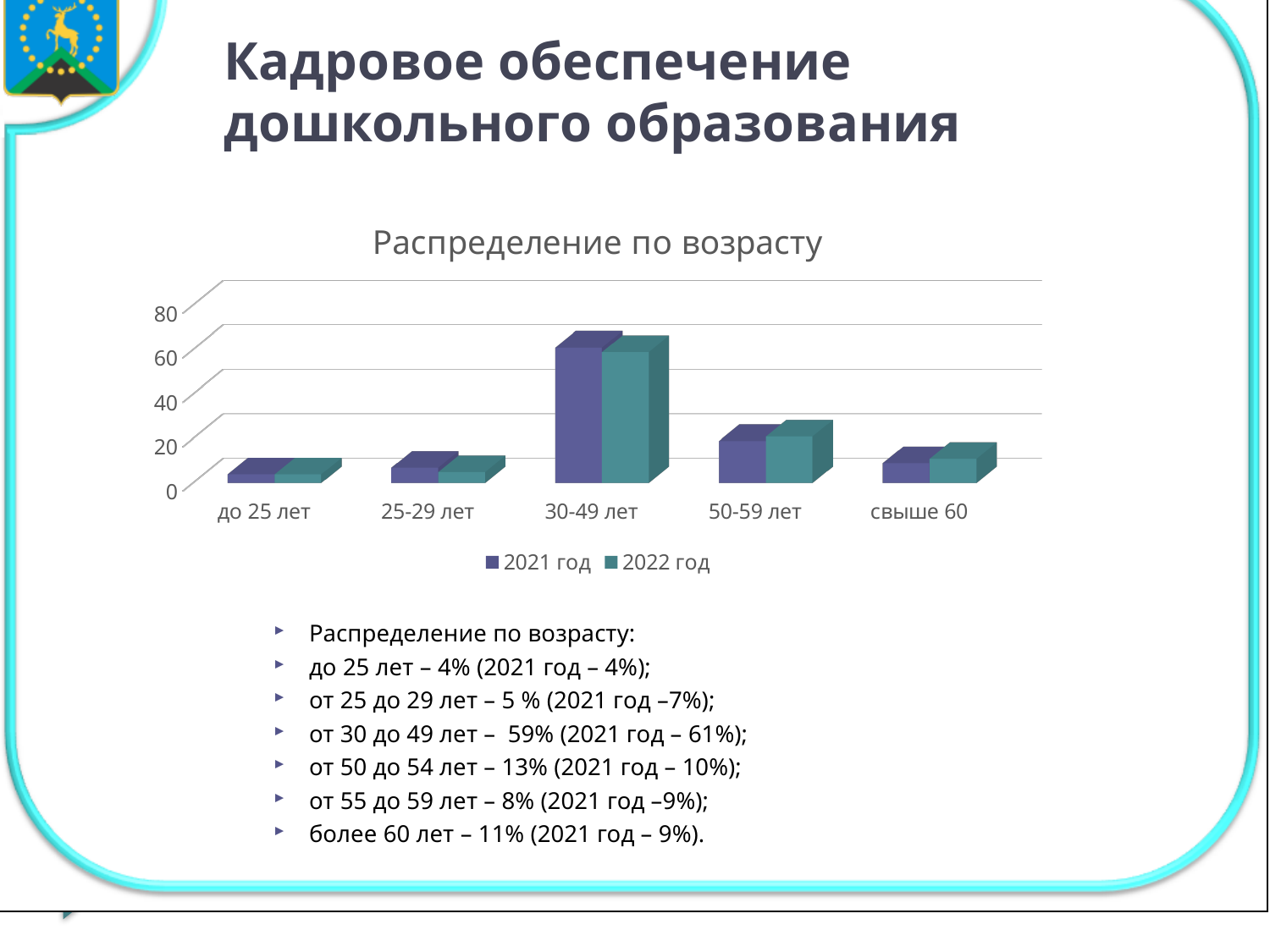
Is the value for до 25 лет in 2021 год greater or less than 20? less How many series does the chart legend list? 2 Is the value for 30-49 лет in 2021 год greater or less than 40? greater Which series are listed in the chart legend? 2021 год, 2022 год Is the value for 30-49 лет in 2022 год greater or less than 40? greater How many age categories are shown on the x axis of the chart? 5 In 2022 год, which is larger: the value for 30-49 лет or the value for 50-59 лет? 30-49 лет Which age category has the highest value for 2022 год? 30-49 лет What is the title of the chart? Распределение по возрасту What kind of chart is shown on the slide? bar chart Which age category has the highest value for 2021 год? 30-49 лет